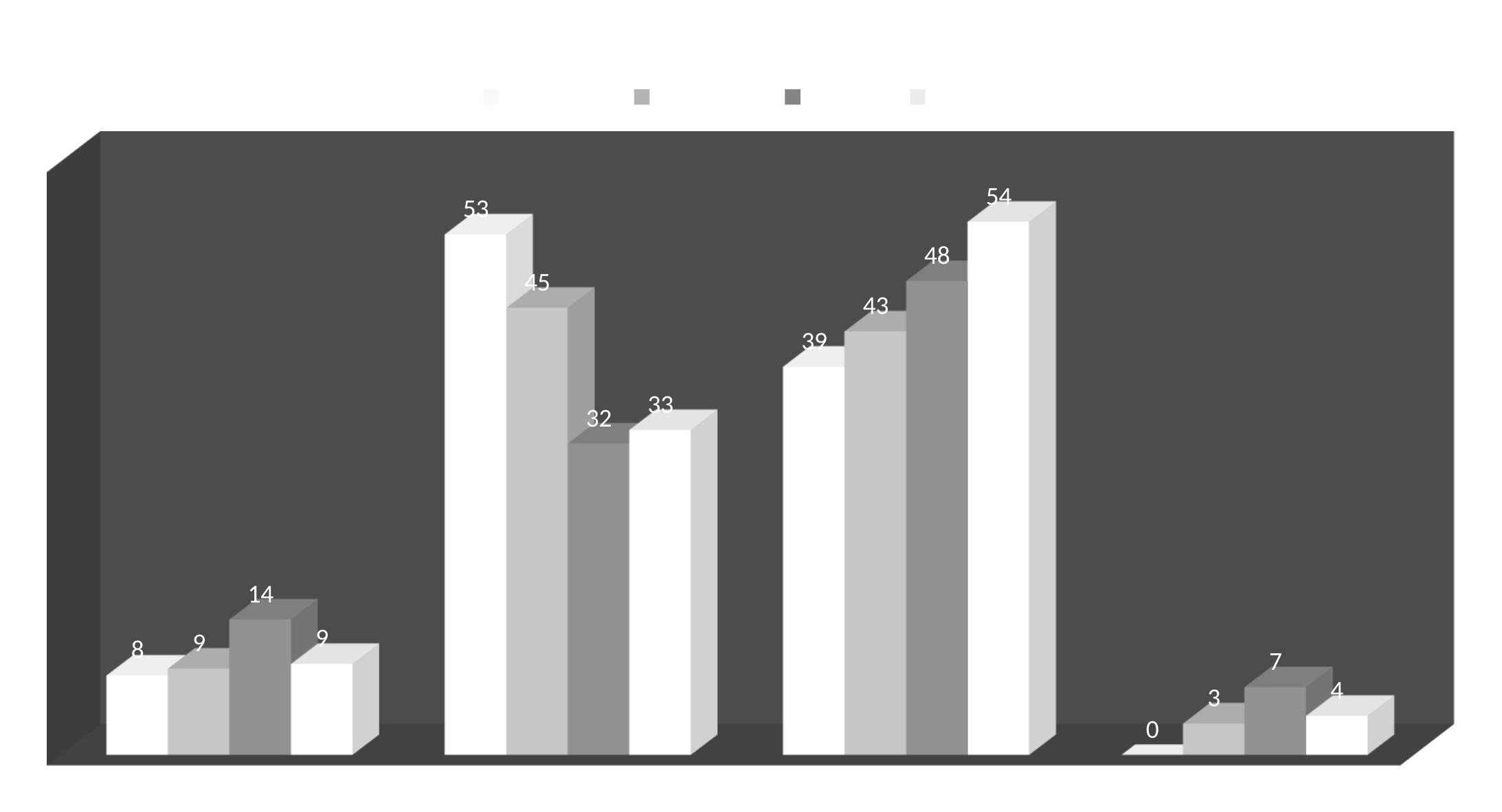
What is the value of the first (leftmost) bar in the third group from the left? 39 What is the lowest value labelled on the chart? 0 In the third group from the left, what is the difference between the fourth bar (54) and the first bar (39)? 15 What kind of chart is shown on the slide? bar chart What is the value of the tallest bar in the second group from the left? 53 Which is larger: the first bar of the second group (53) or the first bar of the third group (39)? the first bar of the second group (53) How many groups of bars are plotted along the x axis? 4 Within the third group from the left, do the bar values rise or fall from left to right? rise What is the value of the third bar in the first group from the left? 14 What is the highest value labelled on the chart? 54 How many series does the legend list? 4 In the second group from the left, what is the difference between the first bar (53) and the third bar (32)? 21